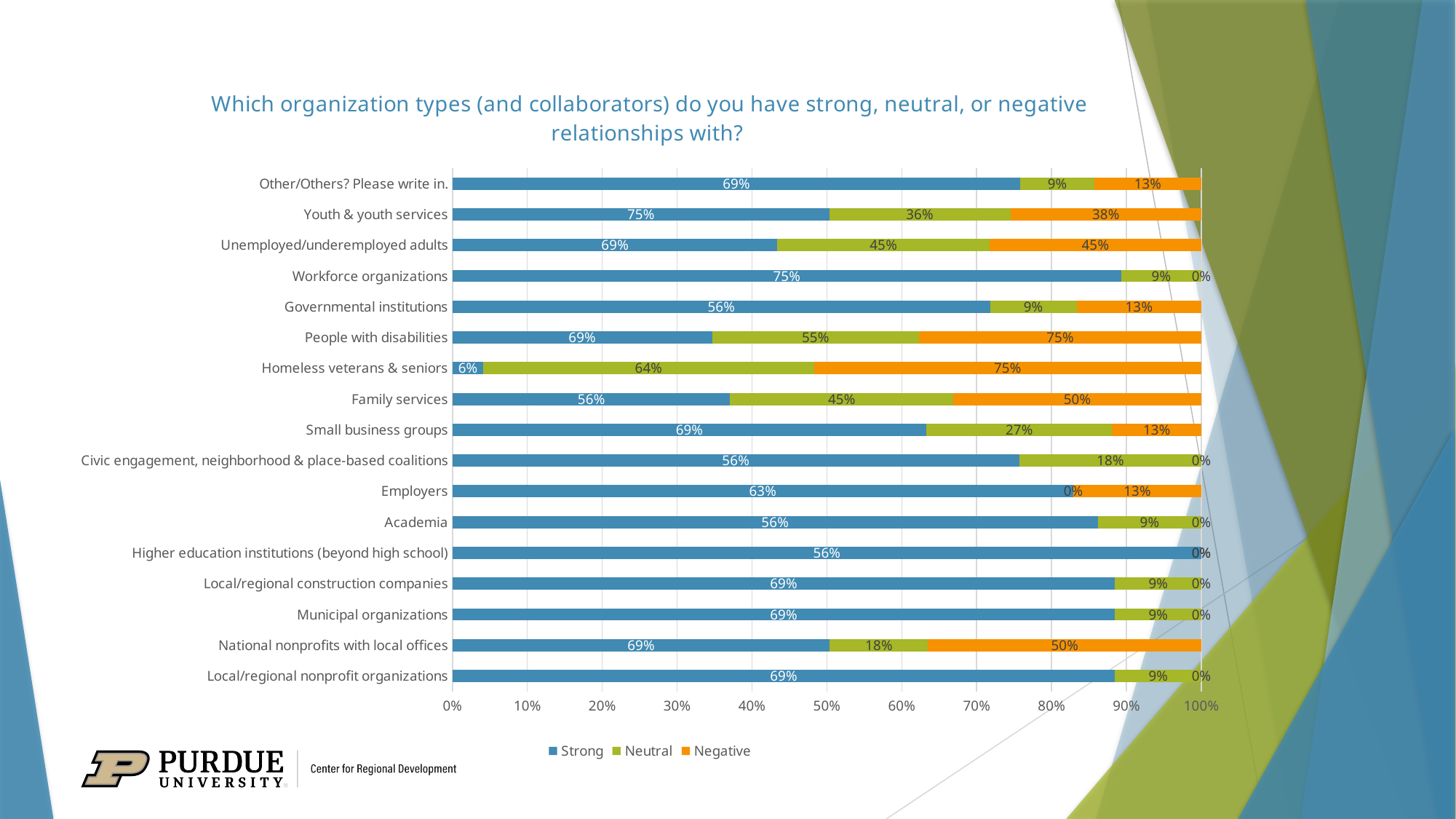
What is the title of the chart? Which organization types (and collaborators) do you have strong, neutral, or negative relationships with? What is the Strong value labeled for Homeless veterans & seniors? 6% How many organization types (categories) are plotted on the chart? 17 What is the Negative value labeled for National nonprofits with local offices? 50% What kind of chart is shown on the slide? Stacked bar chart What is the Strong value labeled for Employers? 63% What is the Neutral value labeled for Small business groups? 27% Which series is shown in orange in the legend? Negative What is the Negative value labeled for People with disabilities? 75% What is the Negative value labeled for Youth & youth services? 38% How many series does the legend list? 3 What is the Neutral value labeled for Homeless veterans & seniors? 64%